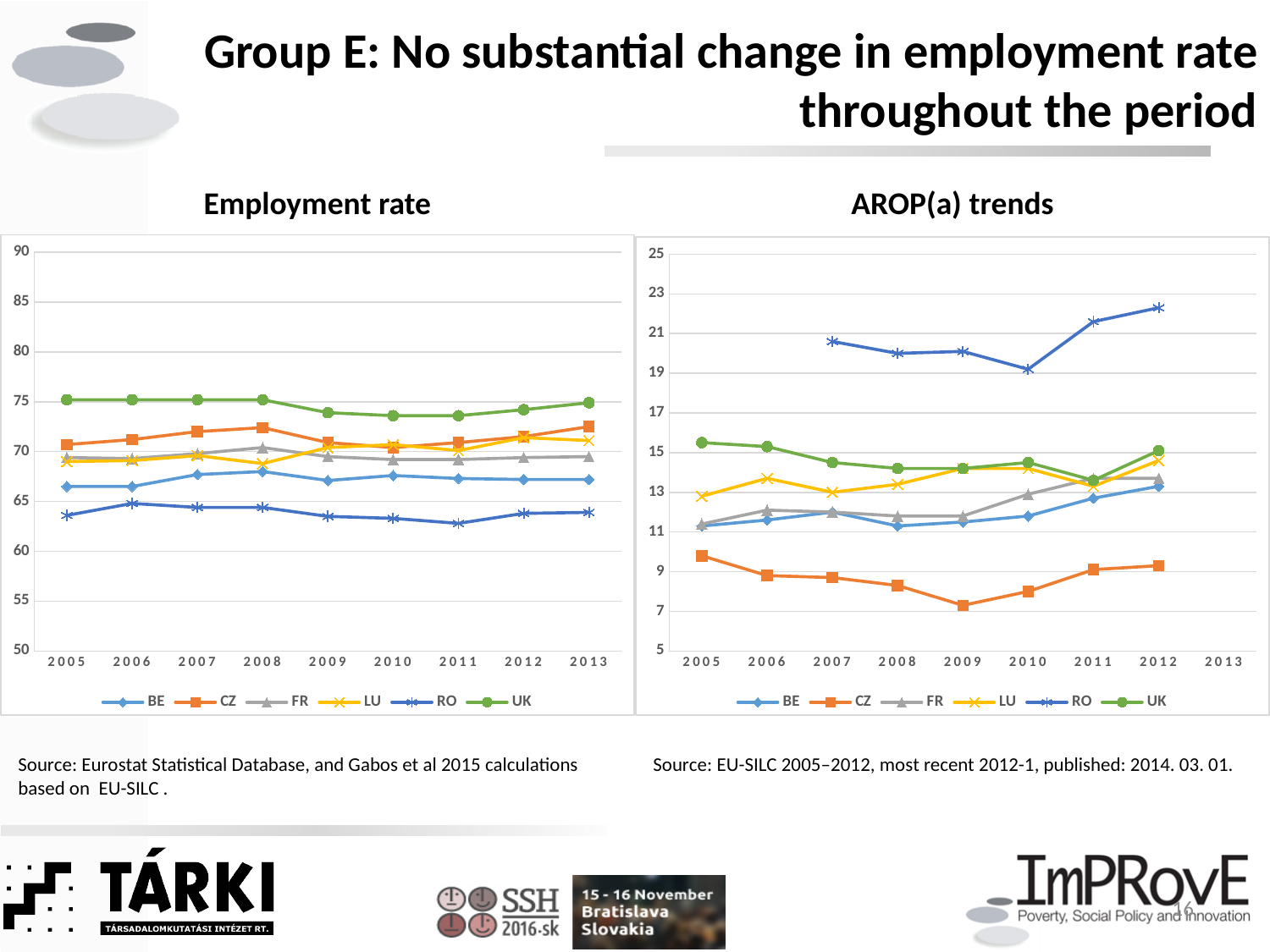
In the Employment rate chart, is the value for UK in 2005 greater or less than 70? greater What kind of chart is the Employment rate chart? line chart In the Employment rate chart, which country has the highest value in 2005? UK In the AROP(a) trends chart, is the value for RO in 2012 greater or less than 21? greater In the Employment rate chart, which country has the lowest value in 2011? RO How many series does the legend of the AROP(a) trends chart list? 6 In the AROP(a) trends chart, is the value for CZ in 2009 greater or less than 9? less In the AROP(a) trends chart, which country has the highest value in 2012? RO In the AROP(a) trends chart, does the value for RO rise or fall from 2011 to 2012? rise How many years are shown on the x axis of the Employment rate chart? 9 In the AROP(a) trends chart, which country has the lowest value in 2009? CZ